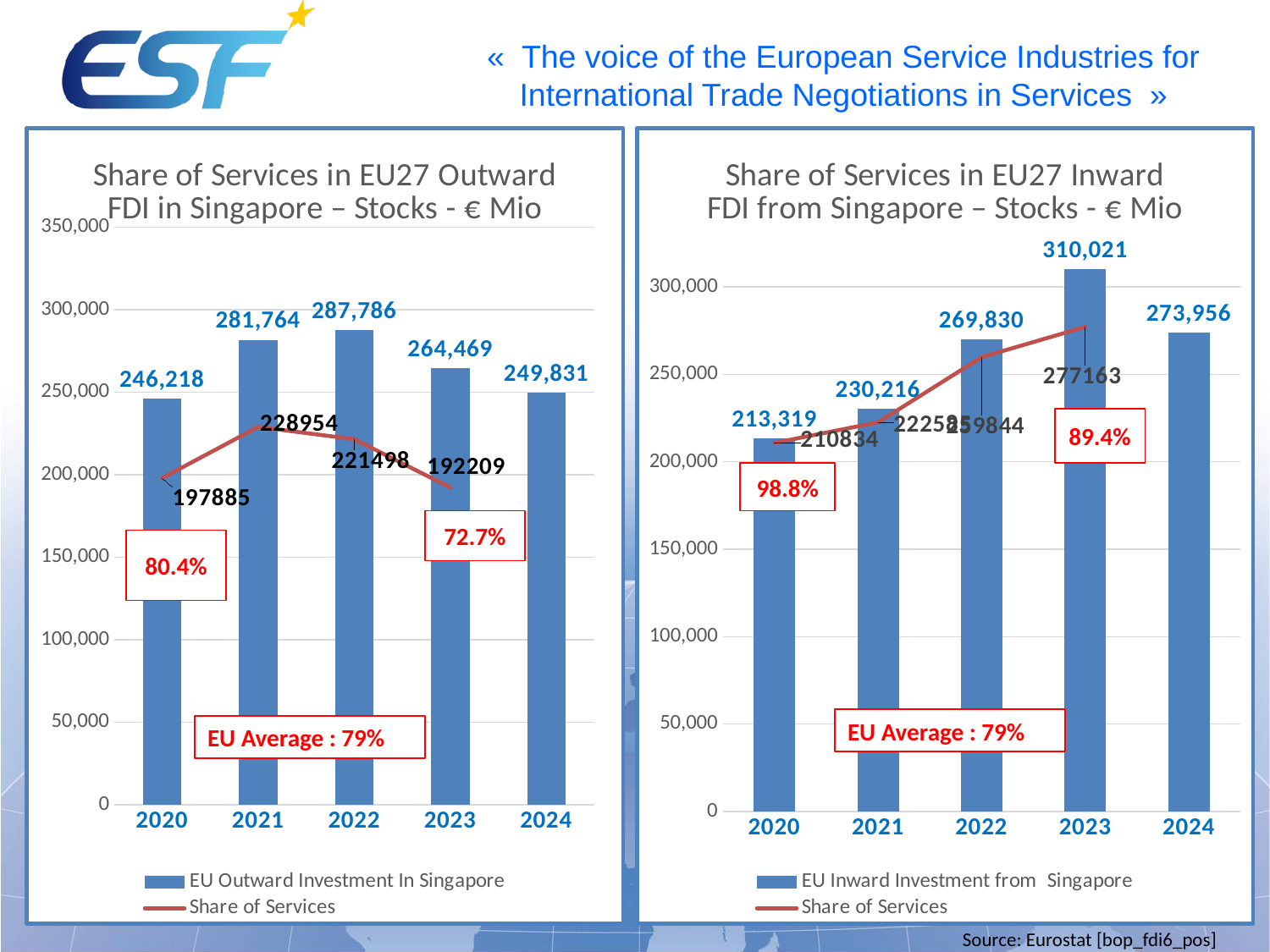
What type of chart is used for the EU Inward Investment from Singapore series in the right-hand chart? bar chart In the 'Share of Services in EU27 Outward FDI in Singapore' chart, what is the Share of Services value for 2020? 197885 In the 'Share of Services in EU27 Outward FDI in Singapore' chart, which year has the lowest EU Outward Investment bar? 2020 In the 'Share of Services in EU27 Inward FDI from Singapore' chart, which year has the lowest EU Inward Investment bar? 2020 In the 'Share of Services in EU27 Outward FDI in Singapore' chart, how many series does the legend list? 2 In the 'Share of Services in EU27 Inward FDI from Singapore' chart, what is the difference between the EU Inward Investment values for 2022 and 2021? 39,614 In the 'Share of Services in EU27 Inward FDI from Singapore' chart, is the EU Inward Investment value for 2024 larger or smaller than the value for 2023? smaller In the 'Share of Services in EU27 Outward FDI in Singapore' chart, what is the value of EU Outward Investment in Singapore for 2022? 287,786 In the 'Share of Services in EU27 Outward FDI in Singapore' chart, what is the difference between the EU Outward Investment values for 2021 and 2020? 35,546 In the 'Share of Services in EU27 Outward FDI in Singapore' chart, which year has the highest EU Outward Investment bar? 2022 In the 'Share of Services in EU27 Inward FDI from Singapore' chart, how many years are shown on the x axis? 5 In the 'Share of Services in EU27 Inward FDI from Singapore' chart, what is the value of EU Inward Investment from Singapore for 2023? 310,021